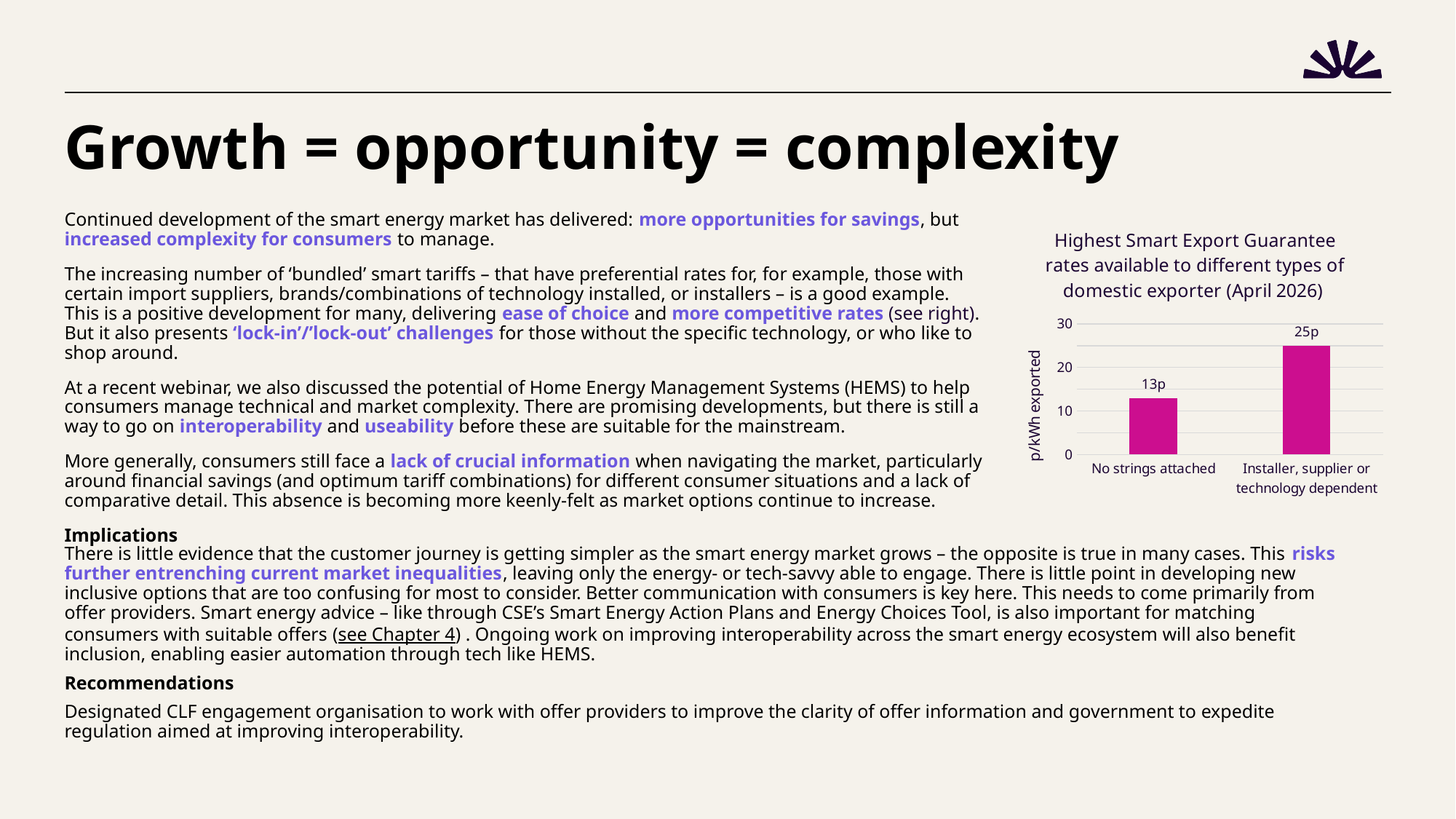
What is the title of the chart? Highest Smart Export Guarantee rates available to different types of domestic exporter (April 2026) How many categories of domestic exporter are shown in the chart? 2 What is the highest Smart Export Guarantee rate for 'Installer, supplier or technology dependent' exporters? 25p Which type of domestic exporter has the lower Smart Export Guarantee rate? No strings attached What is the highest Smart Export Guarantee rate for 'No strings attached' exporters? 13p What is the maximum value shown on the chart's vertical axis? 30 Which type of domestic exporter has the higher Smart Export Guarantee rate? Installer, supplier or technology dependent What kind of chart is shown on the slide? Bar chart What is the label on the vertical axis of the chart? p/kWh exported Is the rate for 'Installer, supplier or technology dependent' greater or less than 20 p/kWh? greater Is the rate for 'No strings attached' greater or less than 20 p/kWh? less What is the difference in p/kWh between the 'Installer, supplier or technology dependent' rate and the 'No strings attached' rate? 12p